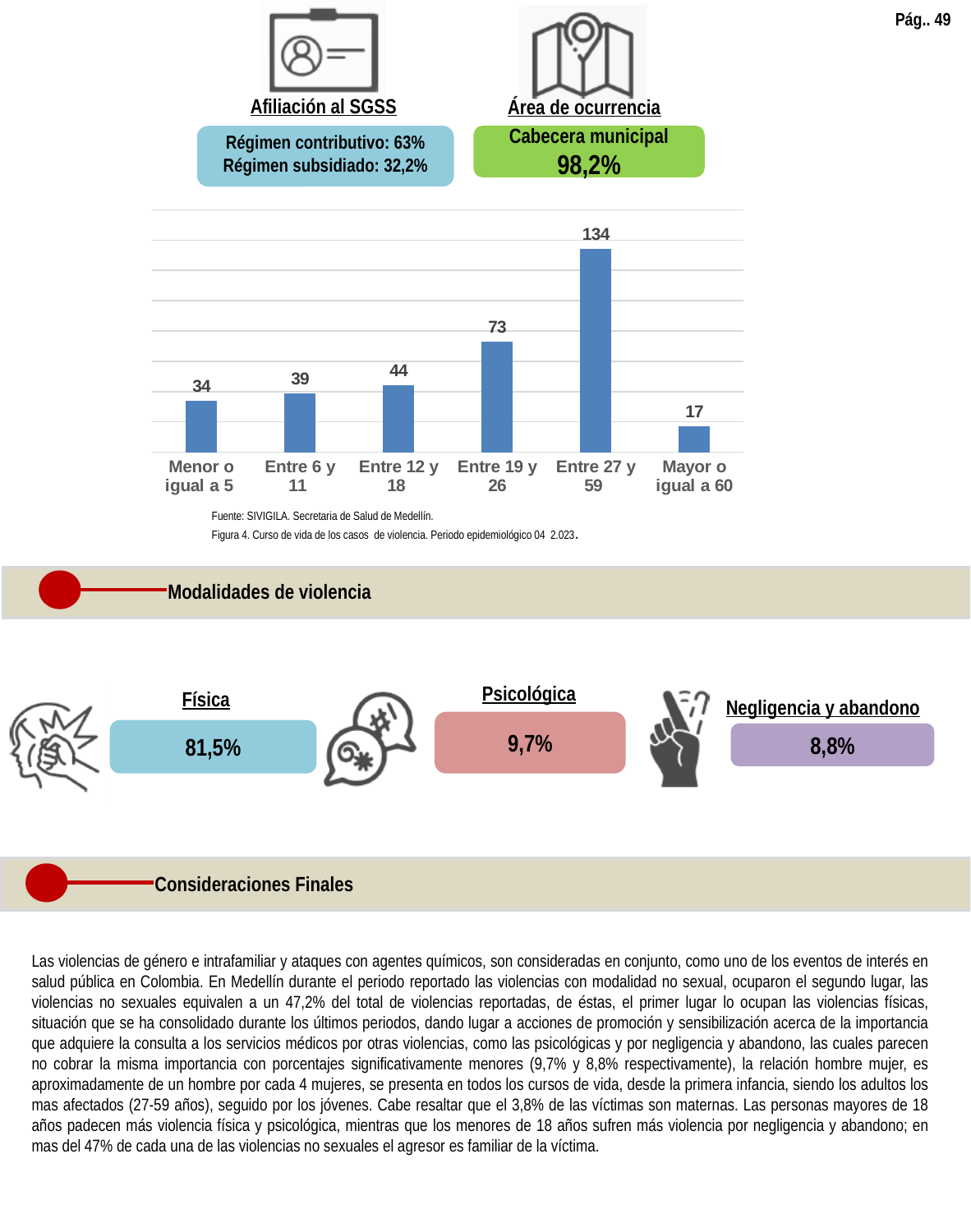
What is the value for the 'Menor o igual a 5' category in the bar chart? 34 Which category has the highest value in the bar chart? Entre 27 y 59 What is the value for the 'Entre 27 y 59' category in the bar chart? 134 What is the difference between the values for 'Entre 27 y 59' and 'Entre 19 y 26' in the bar chart? 61 According to the caption, what figure number is the bar chart? Figura 4 What kind of chart is shown on the slide? Bar chart What is the value for the 'Mayor o igual a 60' category in the bar chart? 17 What is the value for the 'Entre 19 y 26' category in the bar chart? 73 Which is larger in the bar chart, the value for 'Entre 6 y 11' or the value for 'Mayor o igual a 60'? Entre 6 y 11 How many categories are shown on the x axis of the bar chart? 6 Which category has the lowest value in the bar chart? Mayor o igual a 60 What is the difference between the values for 'Entre 12 y 18' and 'Entre 6 y 11' in the bar chart? 5